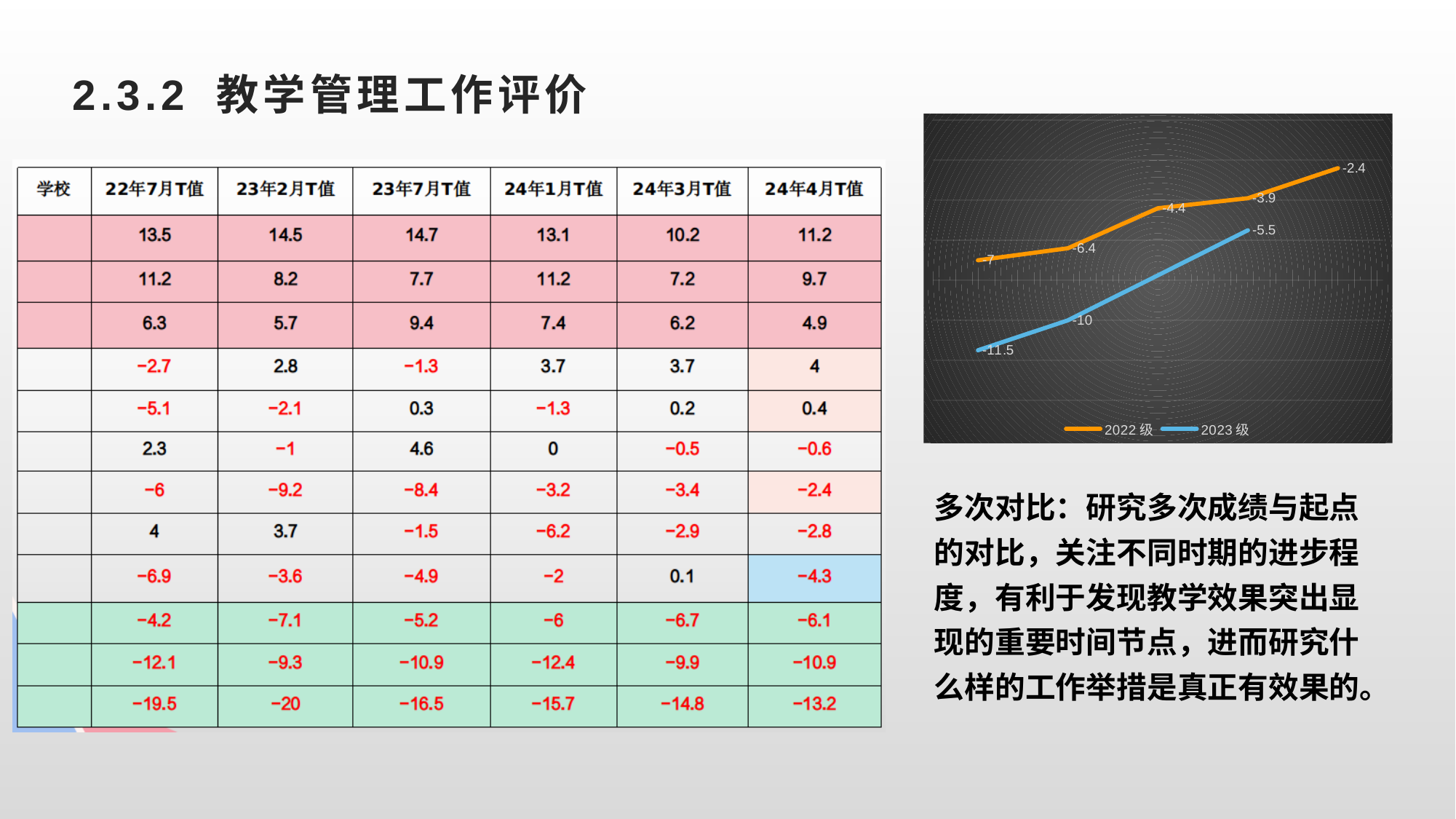
What are the two series named in the legend of the line chart? 2022 级 and 2023 级 How many series does the legend of the line chart list? 2 In the line chart, do the values of the 2022 级 series rise or fall from left to right? rise In the line chart, what is the value of the first data point of the 2022 级 series? -7 In the line chart, what is the value of the second data point of the 2023 级 series? -10 In the line chart, what is the value of the last data point of the 2023 级 series? -5.5 What kind of chart is shown on the right side of the slide? line chart How many data points are plotted for the 2022 级 series in the line chart? 5 In the line chart, what is the value of the first data point of the 2023 级 series? -11.5 In the line chart, what is the difference between the last and first values of the 2023 级 series? 6 In the line chart, what is the value of the last data point of the 2022 级 series? -2.4